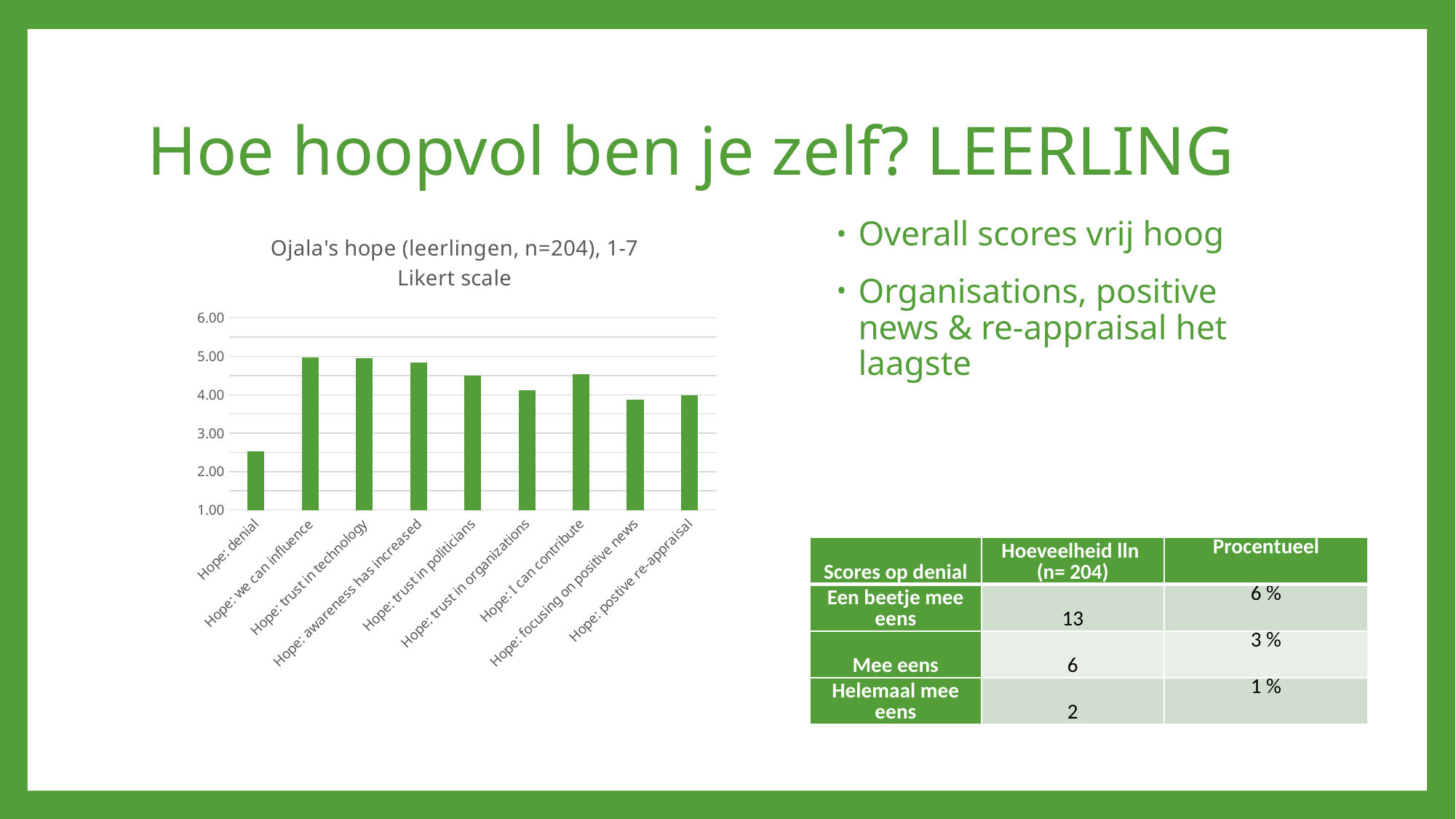
Which is larger, the value for Hope: focusing on positive news or the value for Hope: trust in technology? Hope: trust in technology What is the title of the chart? Ojala's hope (leerlingen, n=204), 1-7 Likert scale Which is larger, the value for Hope: denial or the value for Hope: I can contribute? Hope: I can contribute How many categories are plotted in the chart? 9 Is the value for Hope: we can influence greater or less than 4.00? greater Which category has the lowest value in the chart? Hope: denial Is the value for Hope: trust in organizations greater or less than 5.00? less Is the value for Hope: awareness has increased greater or less than 4.00? greater What kind of chart is shown on the slide? bar chart What is the highest value shown on the chart's vertical axis? 6.00